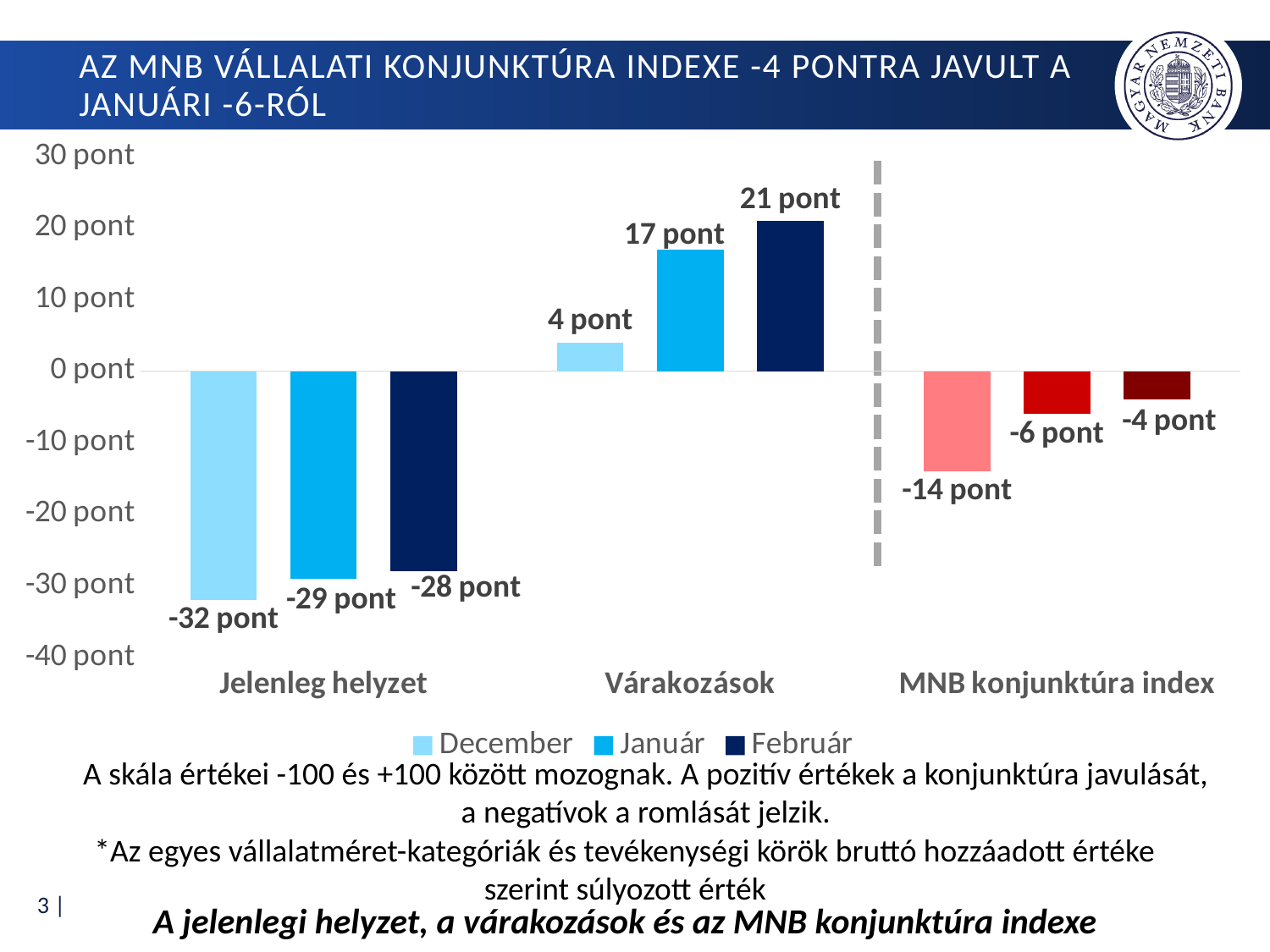
What is the December value for Jelenleg helyzet? -32 pont Which is larger for Jelenleg helyzet: the Január value or the Február value? Február Which series has the lowest value for Jelenleg helyzet? December How many series does the legend list? 3 What kind of chart is shown on the slide? Bar chart What is the Február value for MNB konjunktúra index? -4 pont What is the Január value for Várakozások? 17 pont What is the difference between the Február and December values for Várakozások? 17 pont Which series has the highest value for Várakozások? Február What is the difference between the Január and Február values for MNB konjunktúra index? 2 pont How many categories are shown on the x axis? 3 What is the December value for MNB konjunktúra index? -14 pont